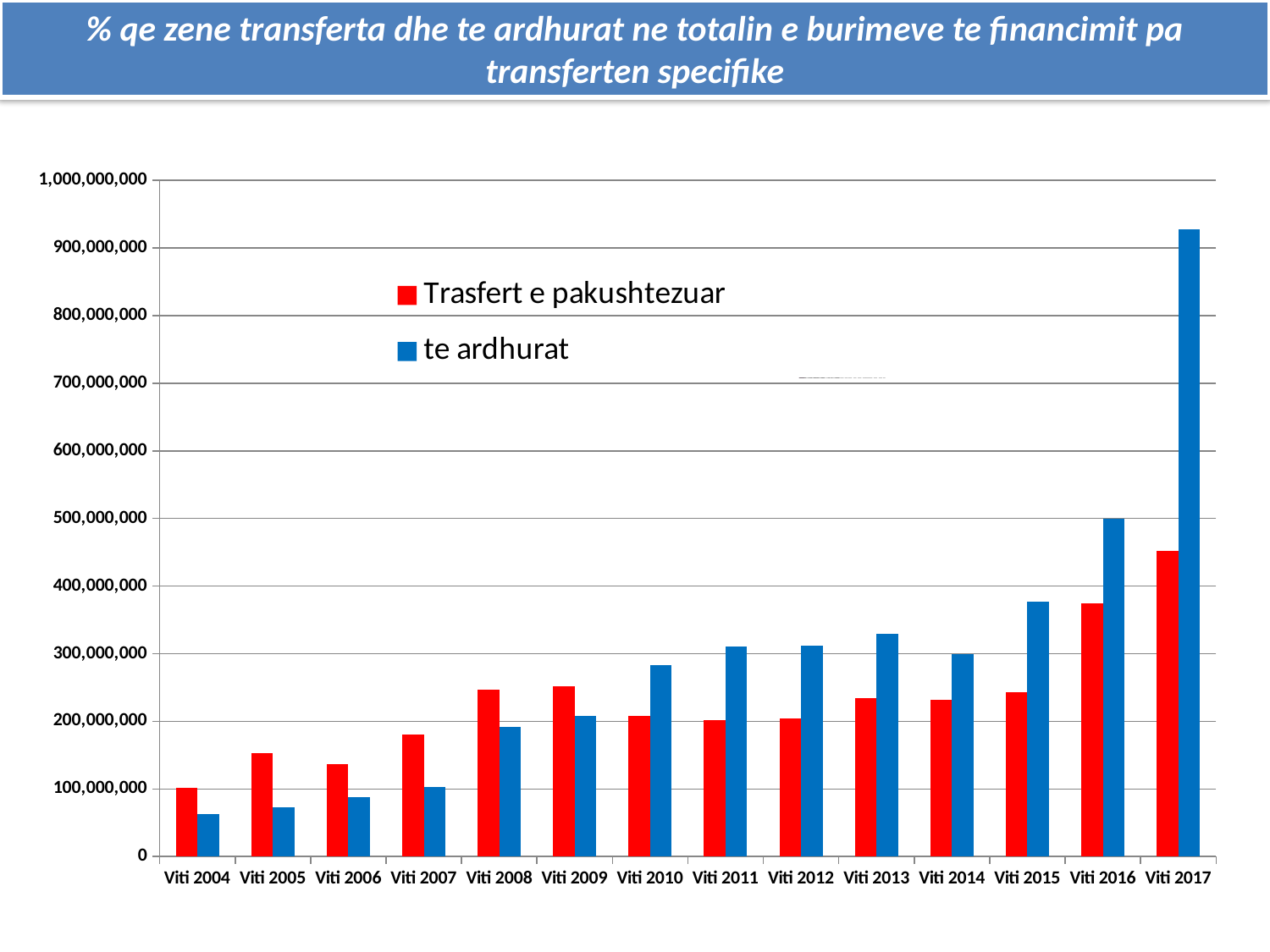
In which year is the value for Trasfert e pakushtezuar lowest? Viti 2004 How many series does the legend list? 2 In Viti 2004, which is larger: Trasfert e pakushtezuar or te ardhurat? Trasfert e pakushtezuar In which year is the value for te ardhurat highest? Viti 2017 In which year is the value for Trasfert e pakushtezuar highest? Viti 2017 Which colour represents te ardhurat in the chart? blue In Viti 2017, which is larger: Trasfert e pakushtezuar or te ardhurat? te ardhurat Is the value for Trasfert e pakushtezuar in Viti 2016 greater or less than 400,000,000? less Is the value for te ardhurat in Viti 2017 greater or less than 800,000,000? greater In which year is the value for te ardhurat lowest? Viti 2004 What kind of chart is shown on the slide? bar chart How many years are shown on the x axis? 14